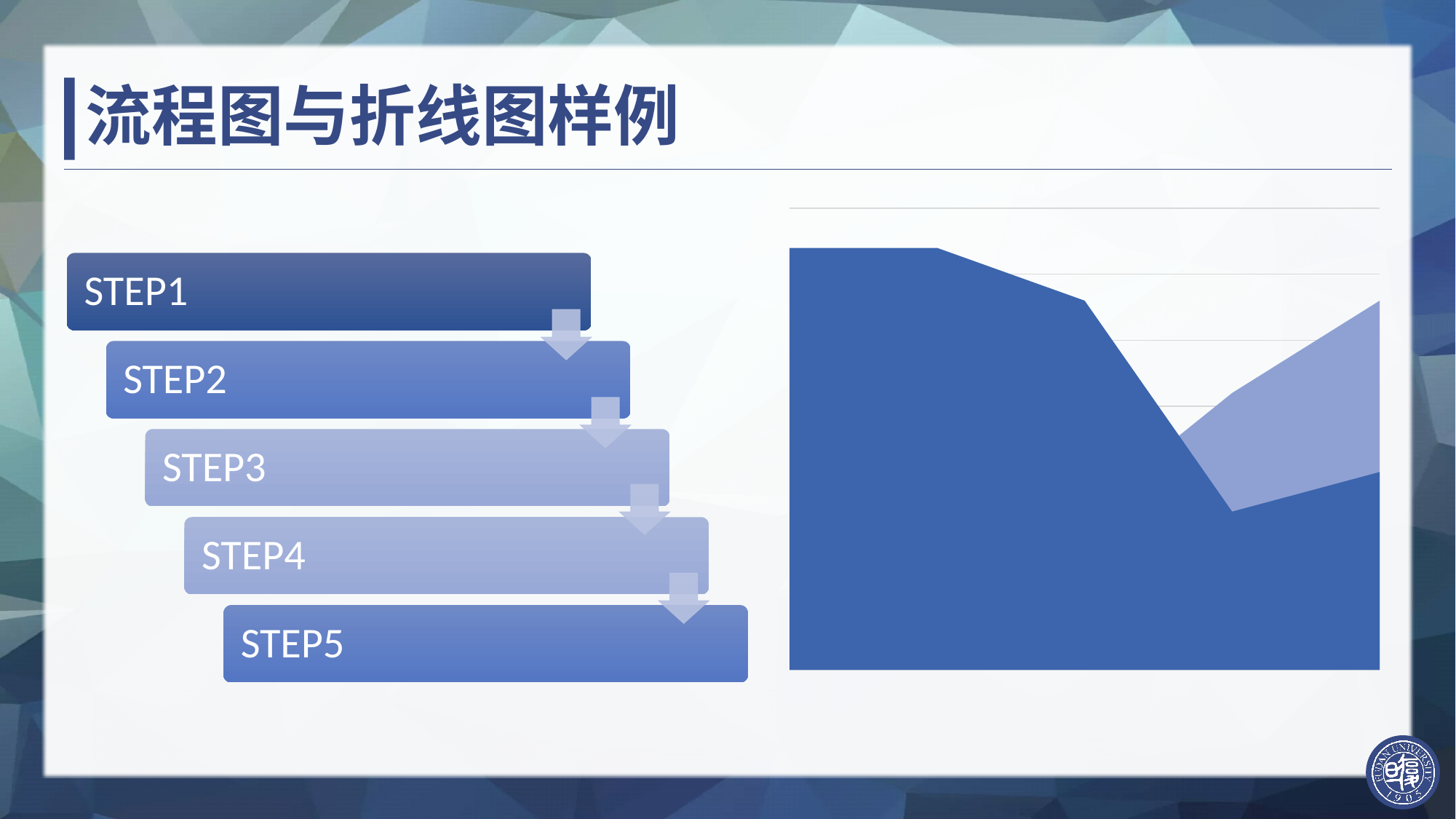
Does the area chart on the right display a legend? No In the area chart on the right, does the value rise or fall from the lowest point to the right edge? rise What colour is the filled area in the chart on the right? blue In the area chart on the right, is the value at the right edge higher or lower than the value at the left edge? lower How many data series are plotted in the area chart on the right? 2 In the area chart on the right, does the value rise or fall from the left edge to the lowest point? fall What kind of chart is shown on the right side of the slide? area chart